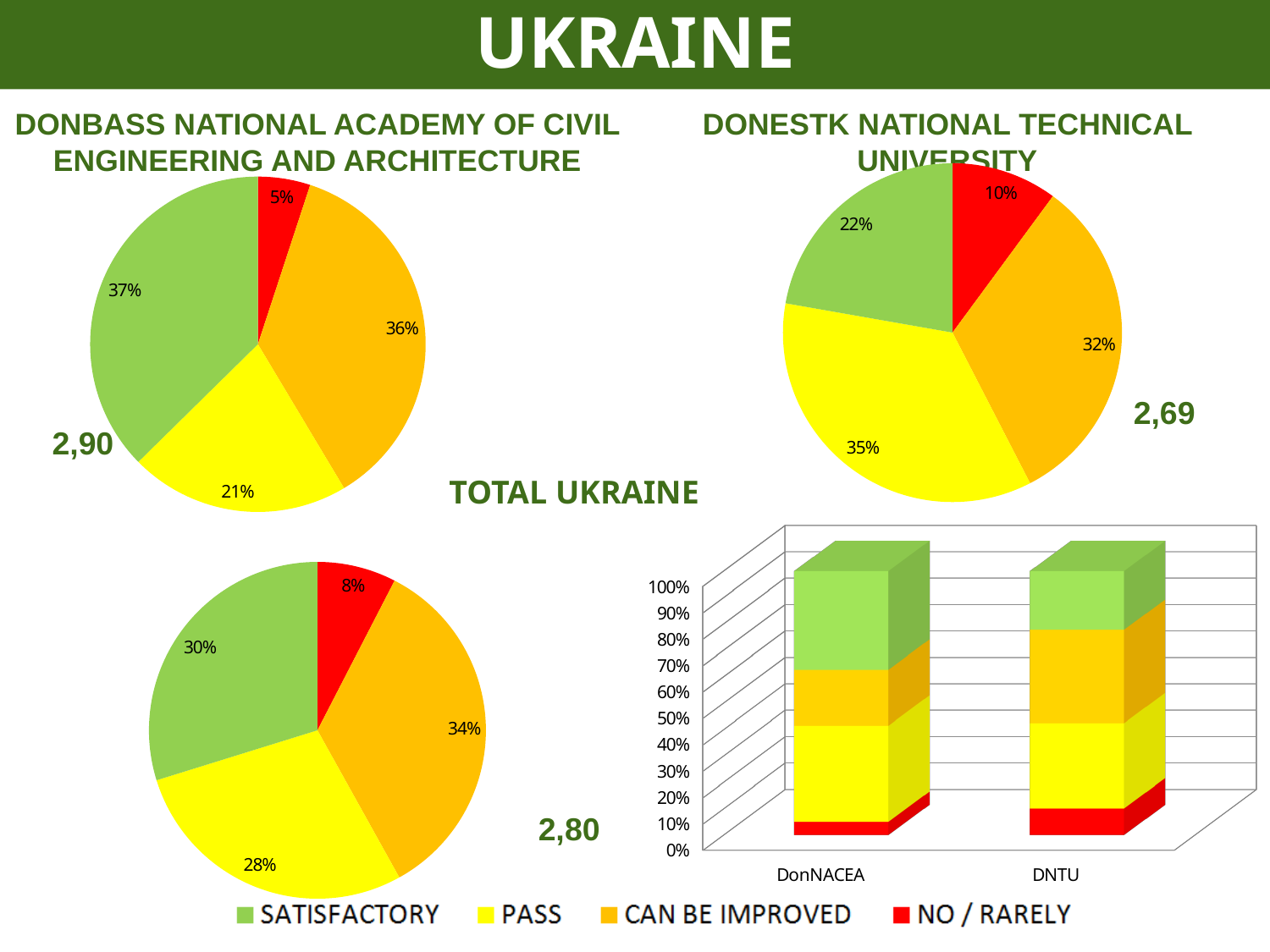
In the Total Ukraine pie chart, what is the difference between the CAN BE IMPROVED slice and the PASS slice? 6% In the Donbass National Academy of Civil Engineering and Architecture pie chart, which is larger: the SATISFACTORY slice or the PASS slice? SATISFACTORY How many slices does the Donetsk National Technical University pie chart have? 4 What type of chart is the chart at the bottom right with the DonNACEA and DNTU categories? Stacked bar chart In the Donbass National Academy of Civil Engineering and Architecture pie chart, what percentage is shown for the NO / RARELY slice? 5% In the Total Ukraine pie chart, what percentage is shown for the SATISFACTORY slice? 30% In the Donetsk National Technical University pie chart, which category has the smallest slice? NO / RARELY In the stacked bar chart at the bottom right, is the NO / RARELY segment for DonNACEA greater or less than 10%? less In the Total Ukraine pie chart, which category has the largest slice? CAN BE IMPROVED In the Donetsk National Technical University pie chart, what percentage is shown for the PASS slice? 35% How many entries does the legend at the bottom of the slide list? 4 In the Donbass National Academy of Civil Engineering and Architecture pie chart, what percentage is shown for the CAN BE IMPROVED slice? 36%